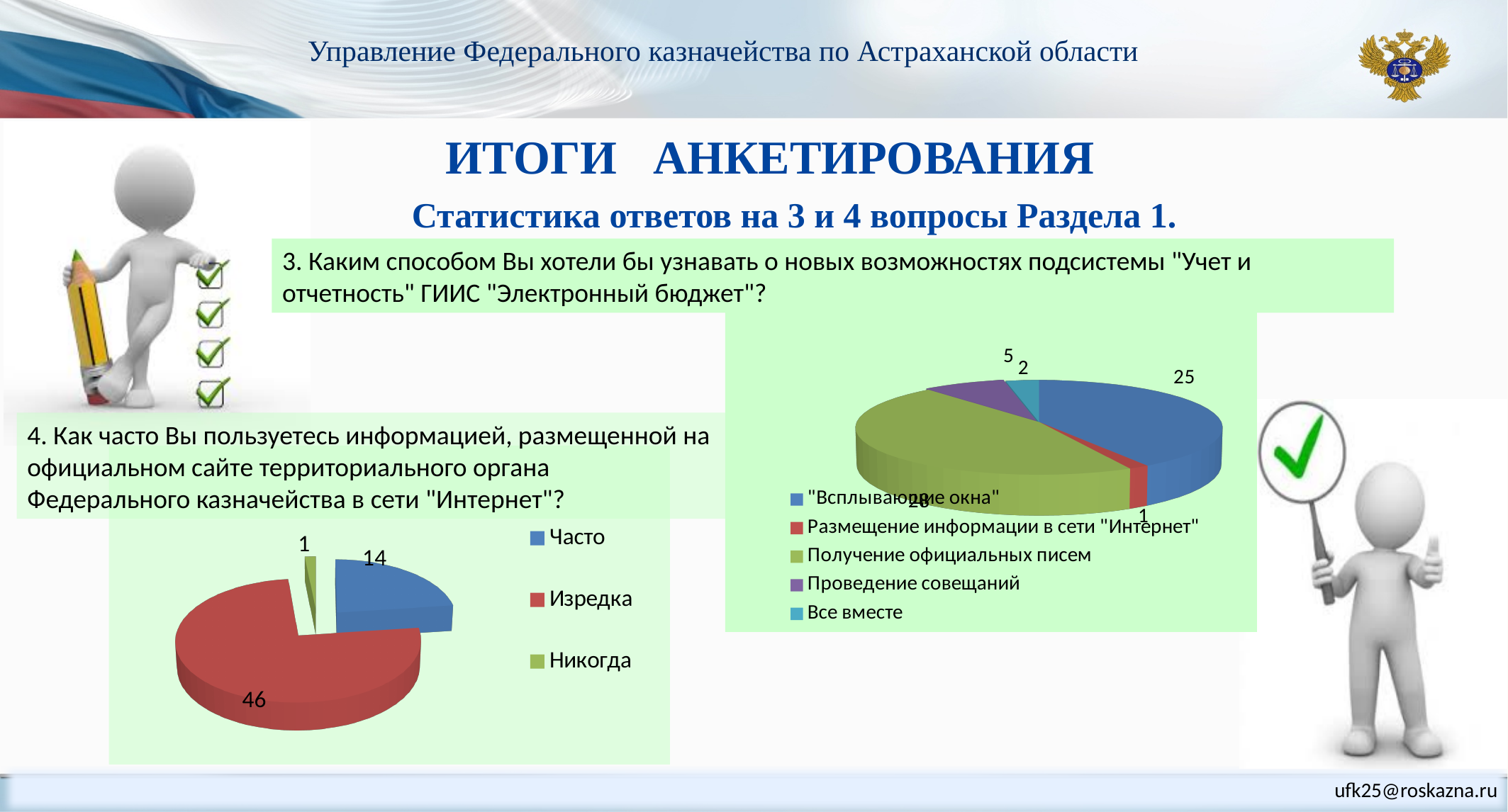
In the pie chart on the left (question 4), which category has the largest slice? Изредка How many categories does the legend of the pie chart on the right (question 3) list? 5 In the pie chart on the left (question 4), which category has the smallest slice? Никогда In the pie chart on the left (question 4), what is the difference between the values for "Изредка" and "Часто"? 32 In the pie chart on the right (question 3), which category has the smallest slice? Размещение информации в сети "Интернет" In the pie chart on the left (question 4), what is the value for "Никогда"? 1 What kind of chart is used for question 4 on the left of the slide? pie chart In the pie chart on the left (question 4), what is the value for "Изредка"? 46 In the pie chart on the right (question 3), what is the value for "Всплывающие окна"? 25 In the pie chart on the right (question 3), what is the value for "Проведение совещаний"? 5 How many categories does the legend of the pie chart on the left (question 4) list? 3 In the pie chart on the left (question 4), what is the value for "Часто"? 14